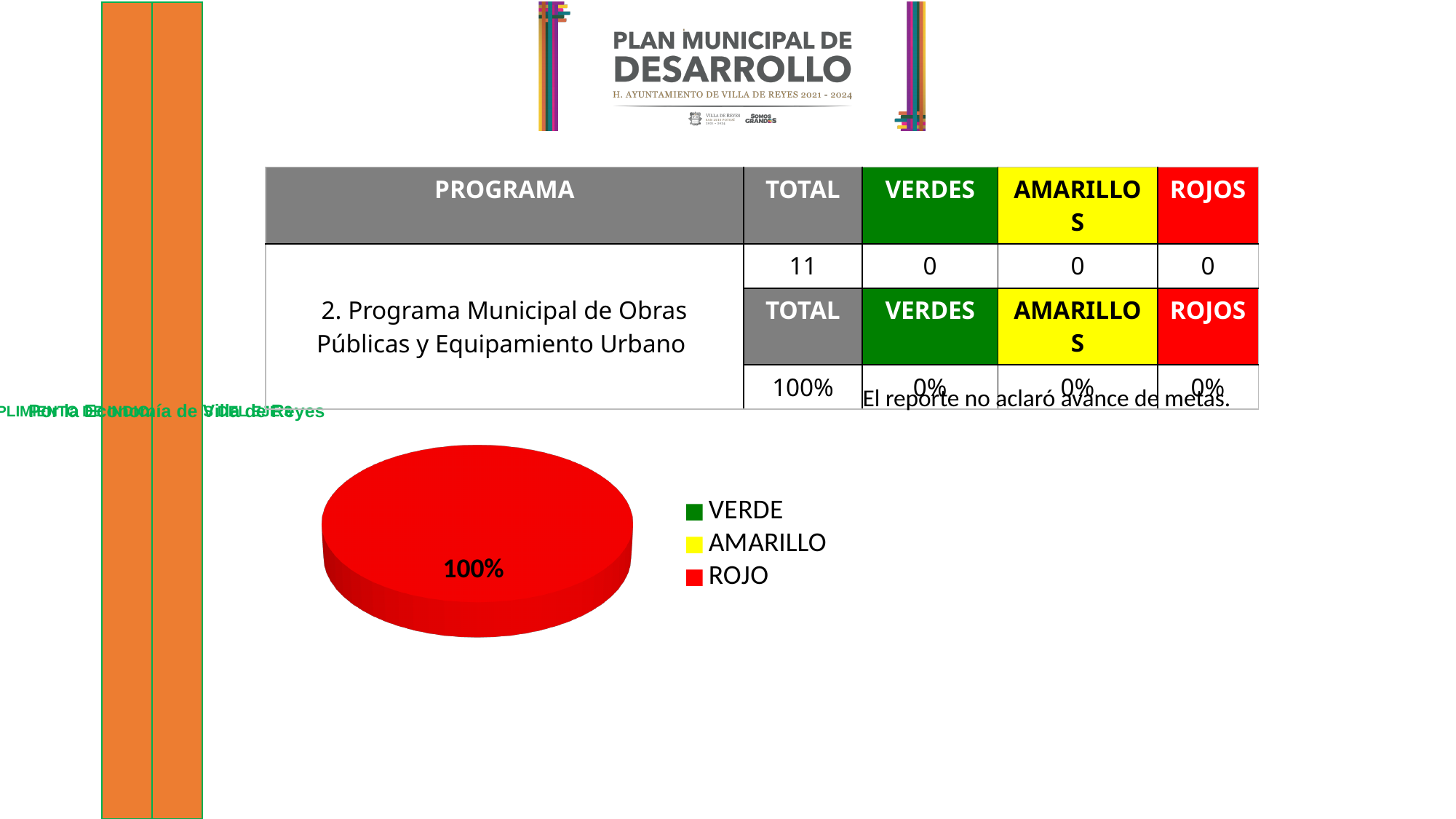
Is the share of the ROJO slice greater or less than 50%? greater Which legend category does the only visible slice of the pie chart belong to? ROJO What percentage label is printed on the pie chart? 100% What colour is the ROJO slice in the pie chart? red What share of the pie does the ROJO slice take? 100% Which category has the largest slice in the pie chart? ROJO Which legend entry is shown in yellow? AMARILLO How many entries does the pie chart's legend list? 3 How many slices are visible in the pie chart? 1 What kind of chart is shown on the slide? pie chart